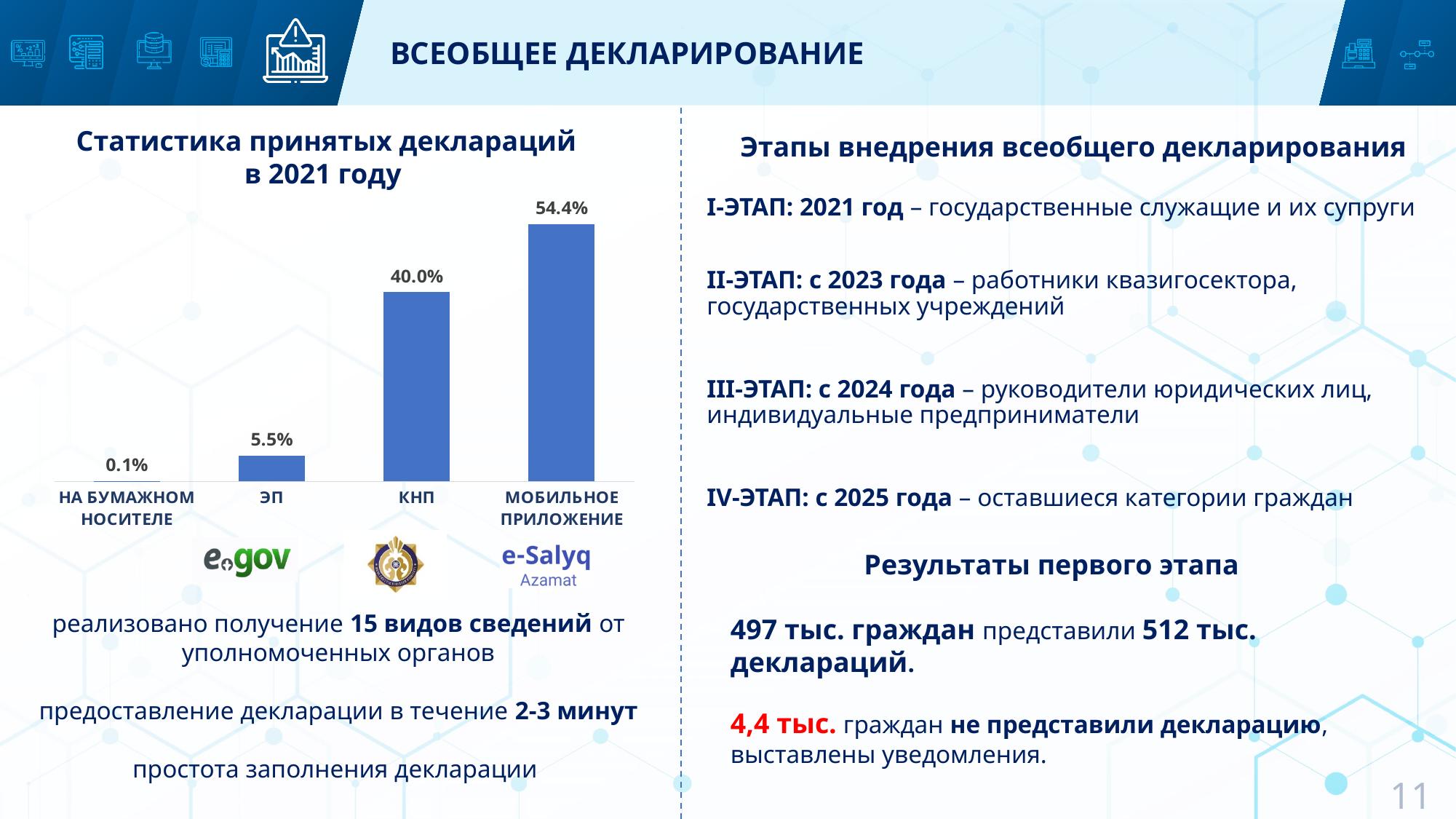
What is the value for ЭП in the chart? 5.5% What is the title of the chart? Статистика принятых деклараций в 2021 году Which category has the lowest value in the chart? НА БУМАЖНОМ НОСИТЕЛЕ What is the difference between the values for ЭП and НА БУМАЖНОМ НОСИТЕЛЕ? 5.4% What is the difference between the values for МОБИЛЬНОЕ ПРИЛОЖЕНИЕ and КНП? 14.4% What is the value for КНП in the chart? 40.0% Which category has the highest value in the chart? МОБИЛЬНОЕ ПРИЛОЖЕНИЕ How many categories are shown in the chart? 4 What kind of chart is shown on the slide? Bar chart What is the value for НА БУМАЖНОМ НОСИТЕЛЕ in the chart? 0.1% Which is larger, the value for КНП or the value for ЭП? КНП What is the value for МОБИЛЬНОЕ ПРИЛОЖЕНИЕ in the chart? 54.4%